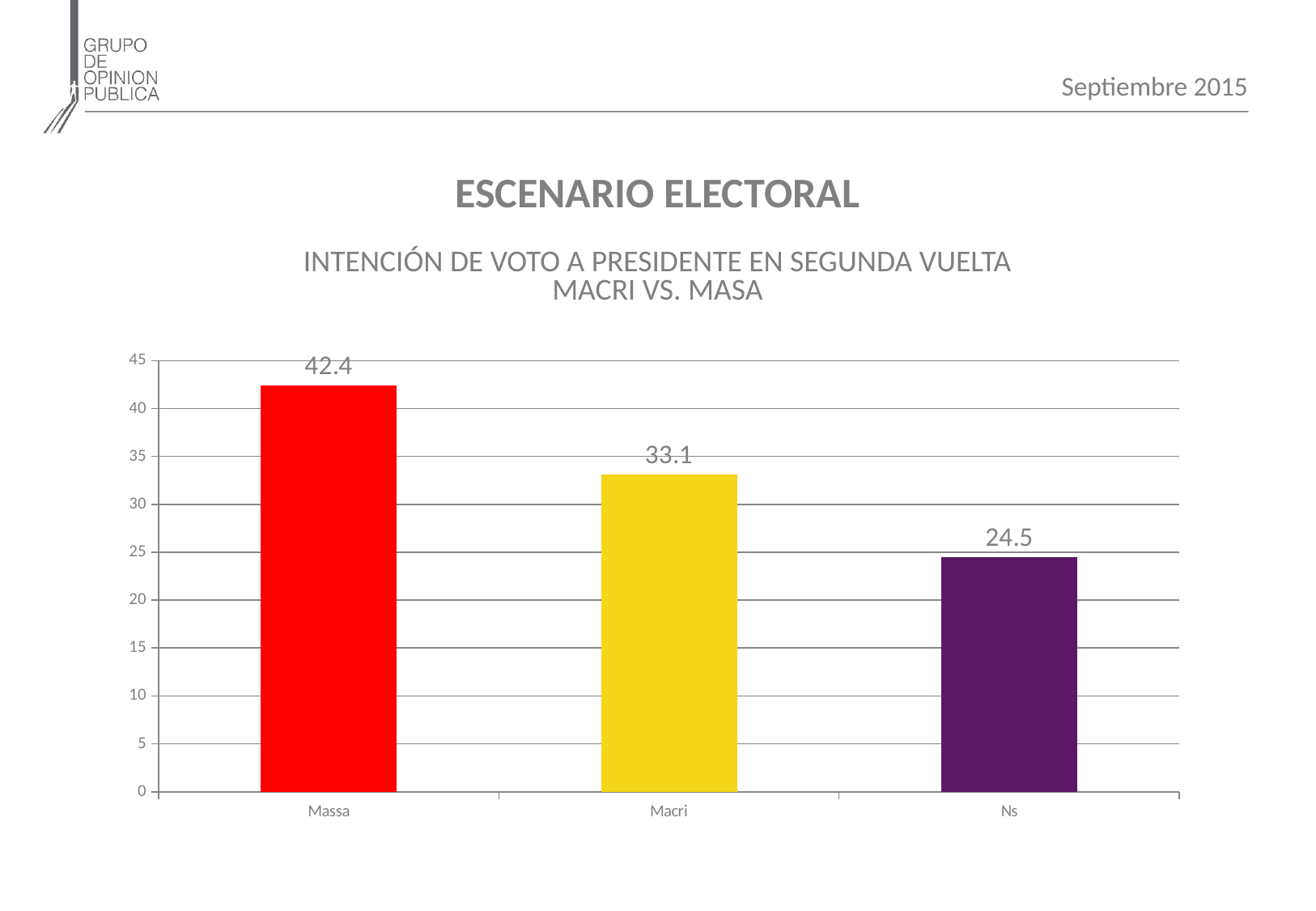
How many categories are shown on the x axis? 3 What is the difference between the values for Macri and Ns? 8.6 What colour is the bar for Macri? yellow What kind of chart is shown on the slide? bar chart What is the value for Macri? 33.1 What is the value for Massa? 42.4 Which is larger, the value for Macri or the value for Ns? Macri Which category has the lowest value? Ns What is the difference between the values for Massa and Macri? 9.3 Is the value for Macri greater or less than 30? greater What is the value for Ns? 24.5 Which category has the highest value? Massa